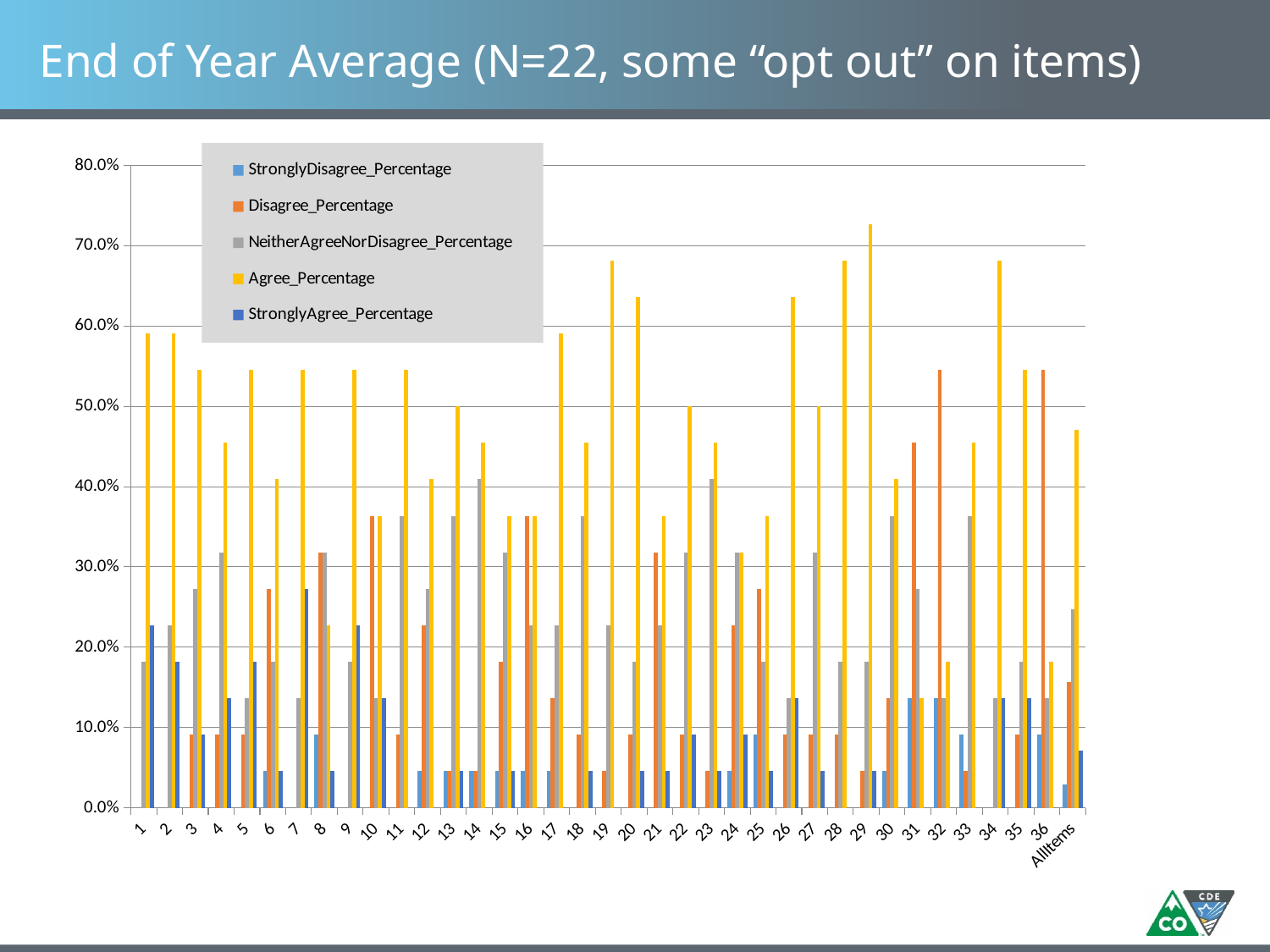
Which item has the highest Agree_Percentage bar? 29 Is the Disagree_Percentage value for item 32 greater or less than 50.0%? greater For item 32, which is larger: the Disagree_Percentage bar or the Agree_Percentage bar? Disagree_Percentage Is the Agree_Percentage value for item 29 greater or less than 70.0%? greater Is the StronglyAgree_Percentage value for item 1 greater or less than 20.0%? greater What kind of chart is shown on the slide? bar chart Which series is shown in yellow in the legend? Agree_Percentage How many series does the legend list? 5 What is the title of the slide containing the chart? End of Year Average (N=22, some "opt out" on items) How many categories are shown along the x axis? 37